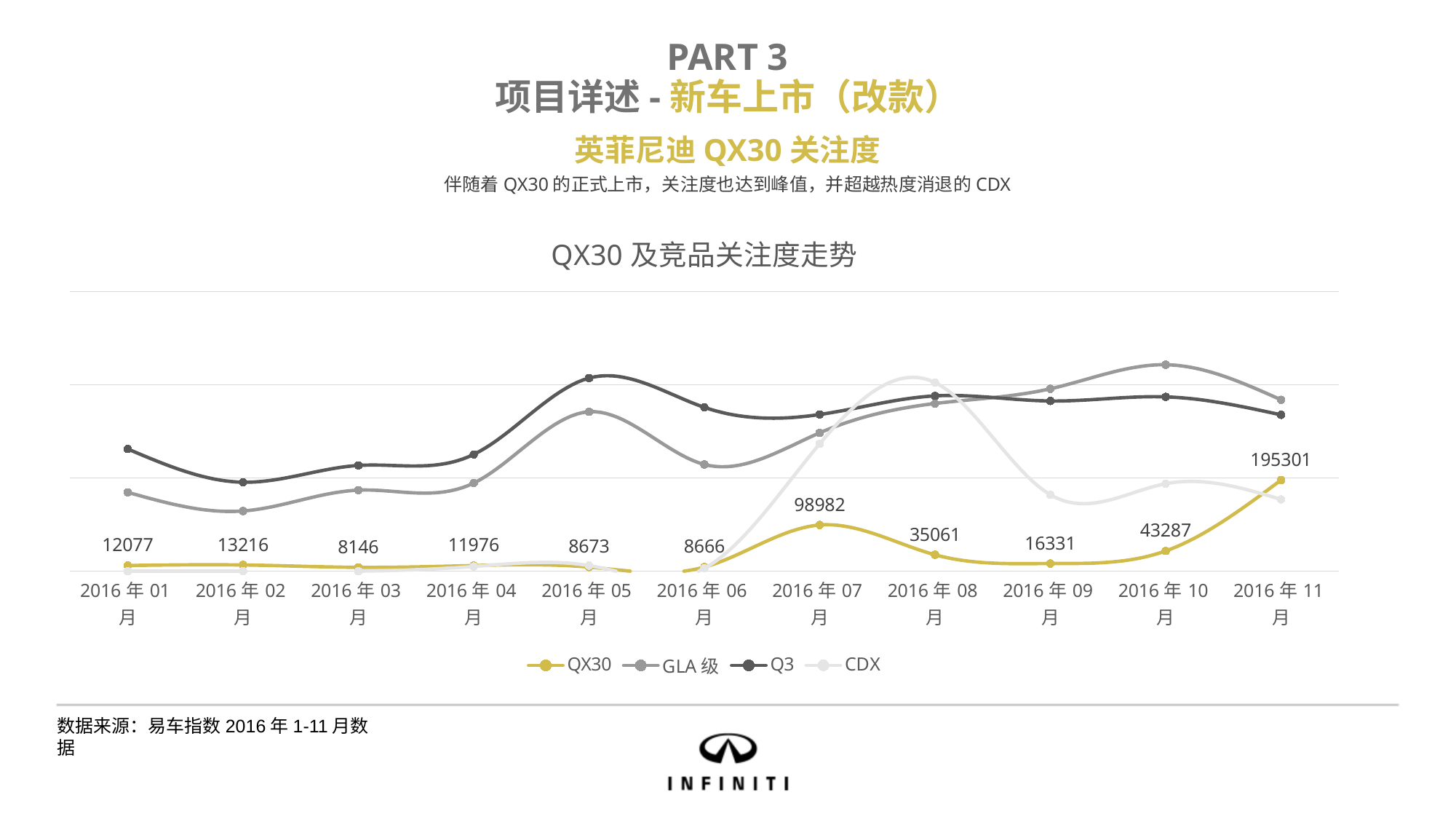
How many months are shown on the x axis? 11 What is the value for QX30 in 2016年07月? 98982 What is the value for QX30 in 2016年11月? 195301 In which month does the QX30 series have its lowest value? 2016年03月 In which month does the QX30 series reach its highest value? 2016年11月 What kind of chart is shown? Line chart What is the value for QX30 in 2016年03月? 8146 What is the title of the chart? QX30 及竞品关注度走势 What is the value for QX30 in 2016年10月? 43287 Which is larger for QX30: the value in 2016年08月 or the value in 2016年09月? 2016年08月 What is the difference between the QX30 values for 2016年11月 and 2016年07月? 96319 How many series does the legend list? 4